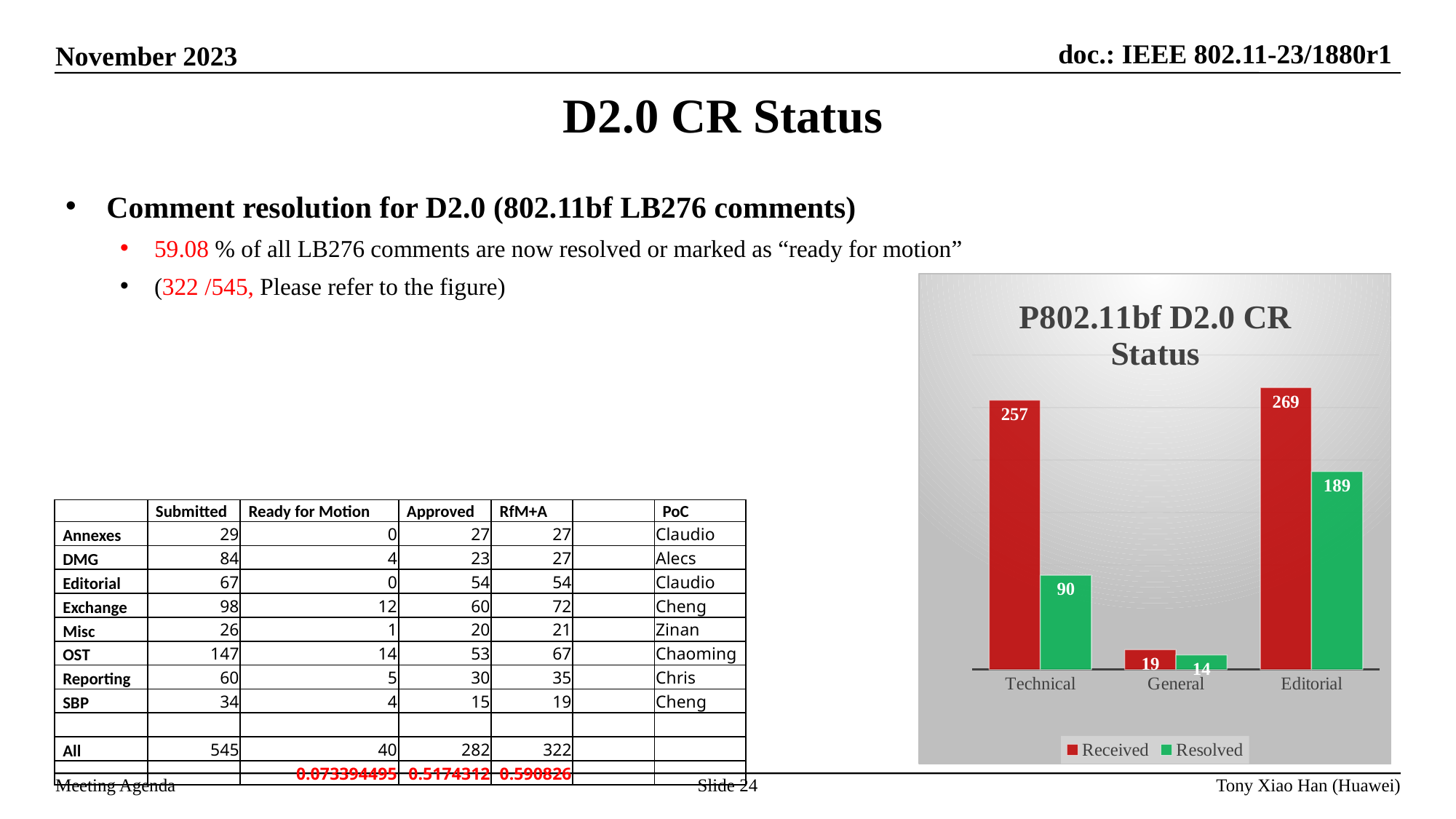
What is the Resolved value for General in the chart? 14 Which is larger in the chart: Resolved for Technical or Resolved for Editorial? Resolved for Editorial What is the Received value for General in the chart? 19 What is the Received value for Technical in the P802.11bf D2.0 CR Status chart? 257 How many series does the chart's legend list? 2 What is the difference between the Received values for Editorial and Technical in the chart? 12 What is the Resolved value for Editorial in the chart? 189 How many categories are shown on the x axis of the chart? 3 Which category has the highest Received value in the chart? Editorial What type of chart is shown on the slide? Bar chart Which category has the lowest Resolved value in the chart? General What is the difference between Received and Resolved for Technical in the chart? 167